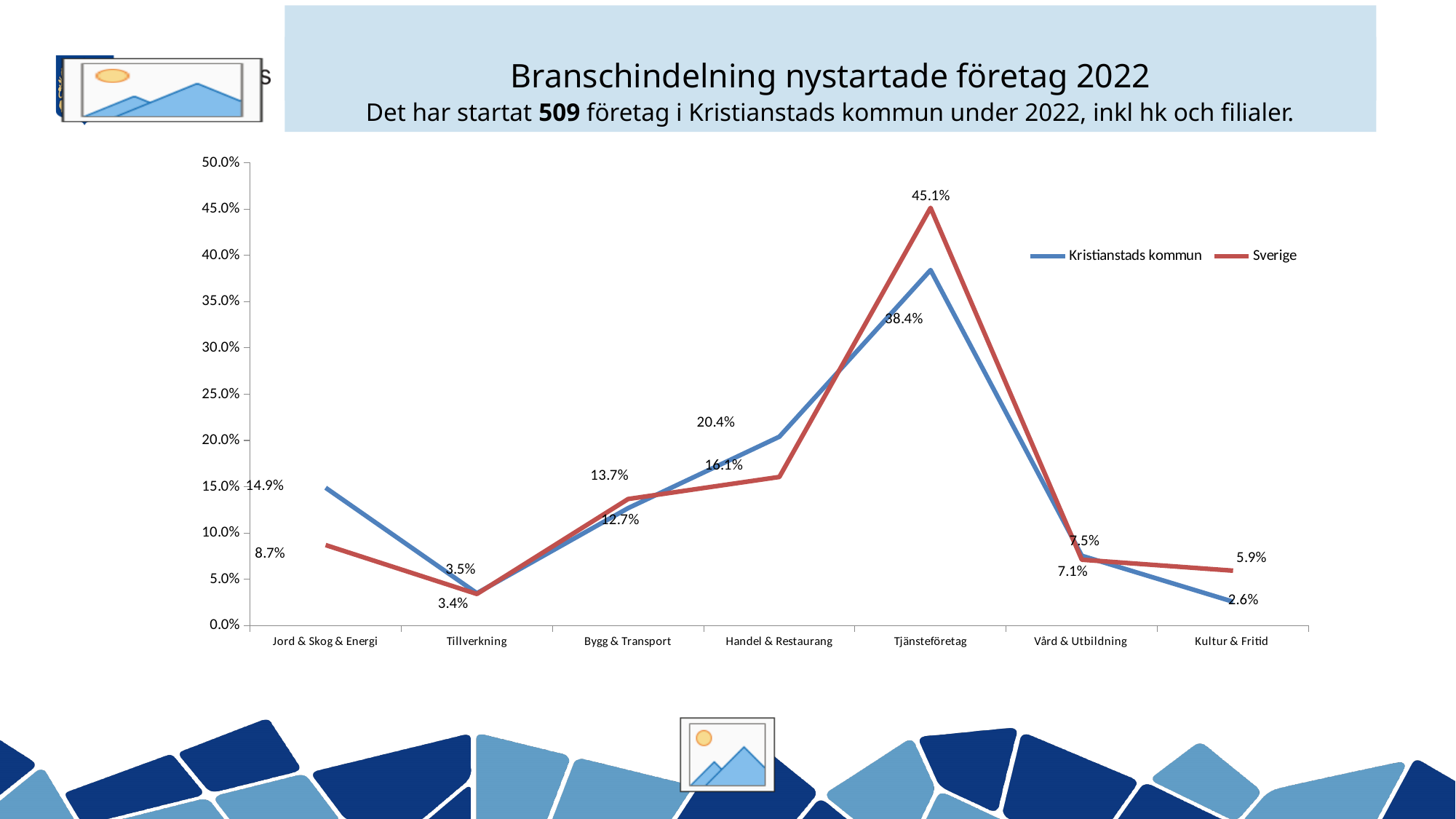
How many categories are shown on the x axis? 7 What is the value for Kristianstads kommun in Jord & Skog & Energi? 14.9% What is the value for Sverige in Tjänsteföretag? 45.1% What is the difference between Sverige and Kristianstads kommun in Tjänsteföretag? 6.7% How many series does the legend list? 2 What is the value for Sverige in Kultur & Fritid? 5.9% Which is larger in Handel & Restaurang, Kristianstads kommun or Sverige? Kristianstads kommun Which category has the highest value for Sverige? Tjänsteföretag What kind of chart is shown on the slide? line chart Which category has the lowest value for Kristianstads kommun? Kultur & Fritid What is the value for Kristianstads kommun in Tjänsteföretag? 38.4% Which series is drawn in red? Sverige